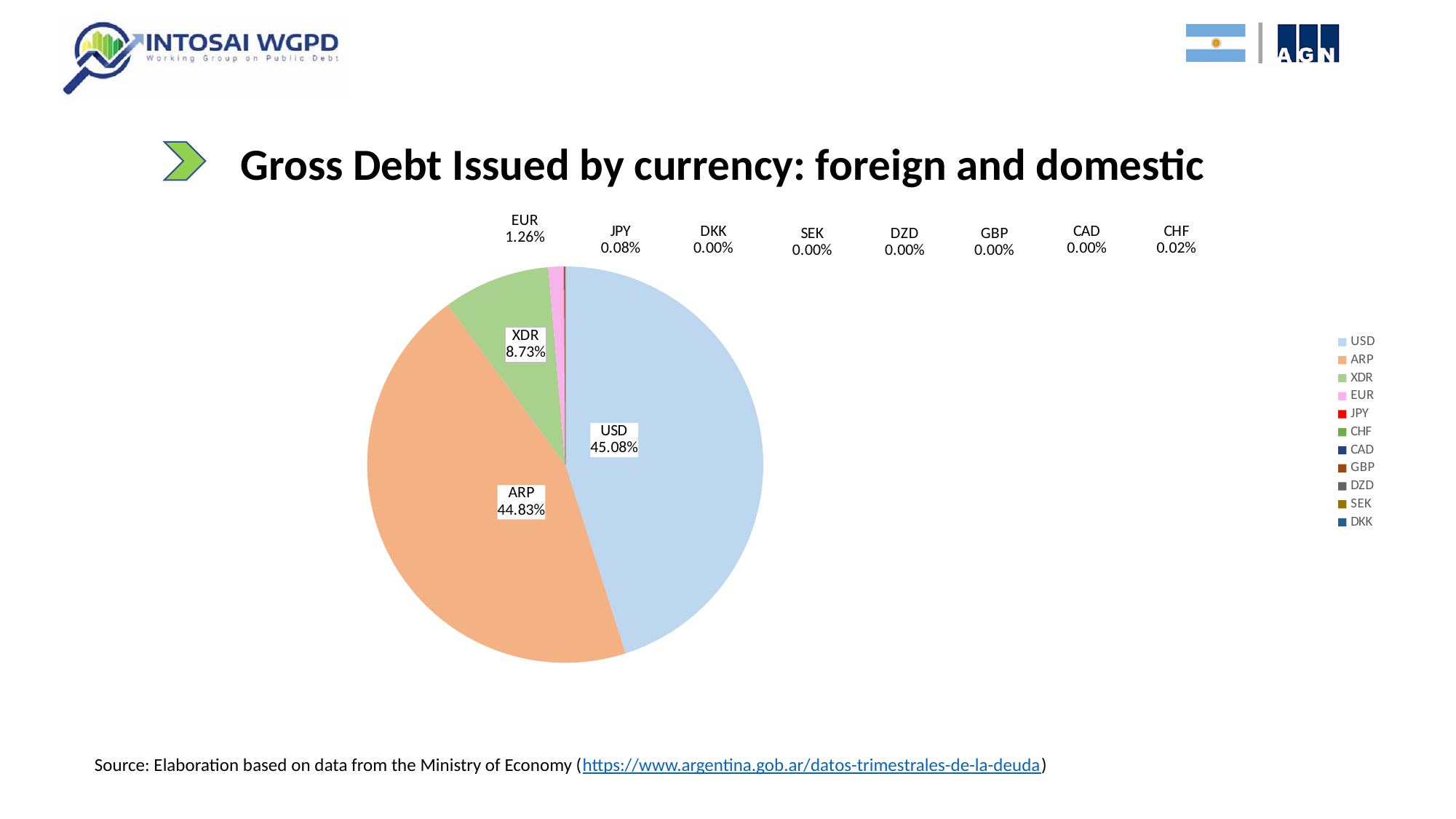
What share of gross debt issued is in ARP? 44.83% What type of chart is shown on the slide? Pie chart What is the share shown for JPY? 0.08% What is the difference in percentage points between the USD share and the ARP share? 0.25% How many currencies does the legend list? 11 What is the share shown for EUR? 1.26% What is the share shown for CHF? 0.02% Which is larger, the share for USD or the share for ARP? USD What percentage does the XDR slice represent? 8.73% What is the difference between the XDR share and the EUR share? 7.47% What share of gross debt issued is in USD? 45.08% Which currency has the largest share of gross debt issued? USD